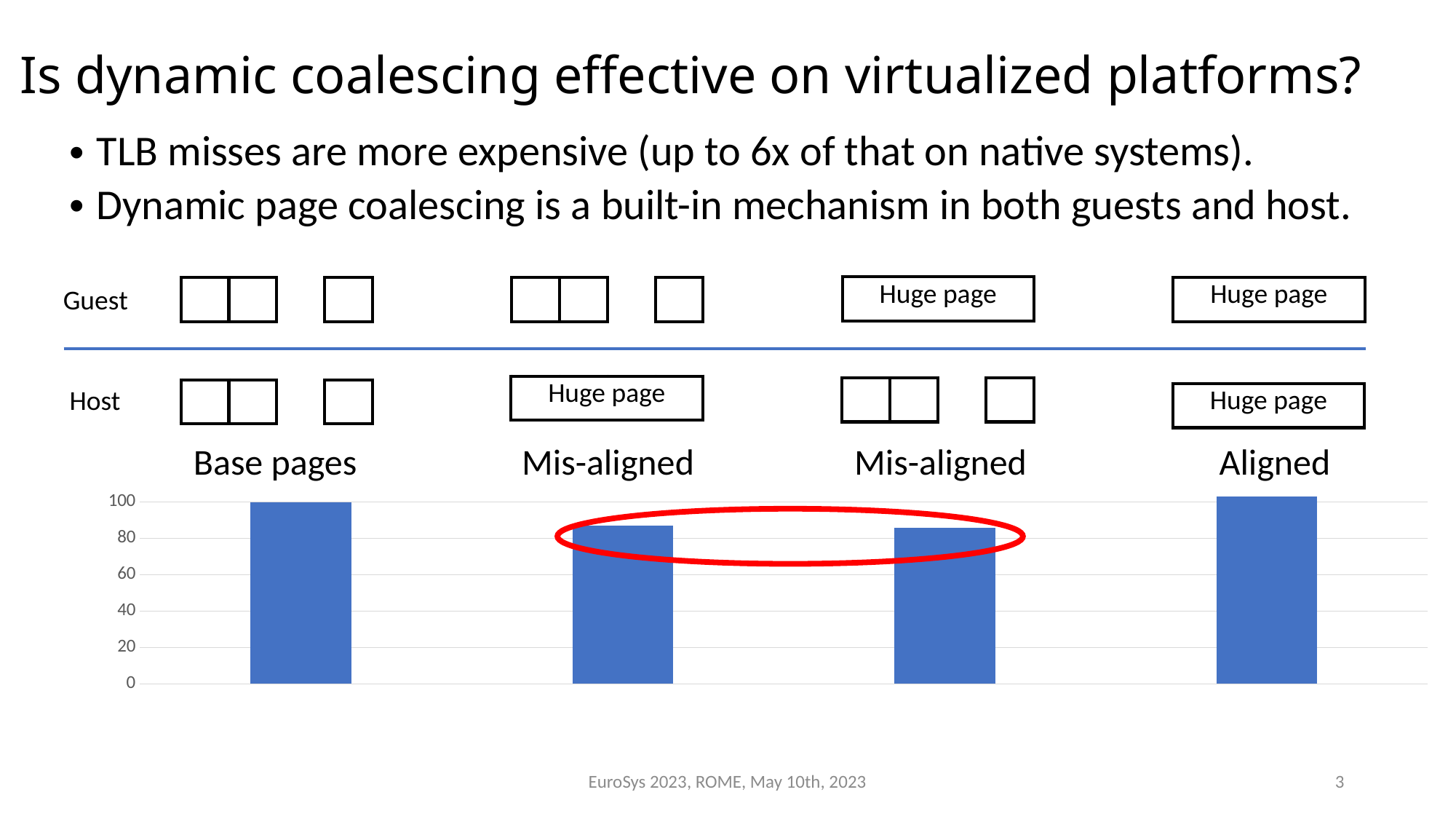
What kind of chart is shown on the slide? bar chart Is the value of the Aligned bar greater or less than 80? greater What is the highest value shown on the vertical axis? 100 Which is larger, the Aligned bar or the second Mis-aligned bar? Aligned Is the value of the first Mis-aligned bar greater or less than 80? greater How many bars are plotted in the chart? 4 Is the value of the second Mis-aligned bar greater or less than 100? less Which bars are circled in red on the chart? the two Mis-aligned bars What is the value of the Base pages bar? 100 Which is larger, the Base pages bar or the first Mis-aligned bar? Base pages